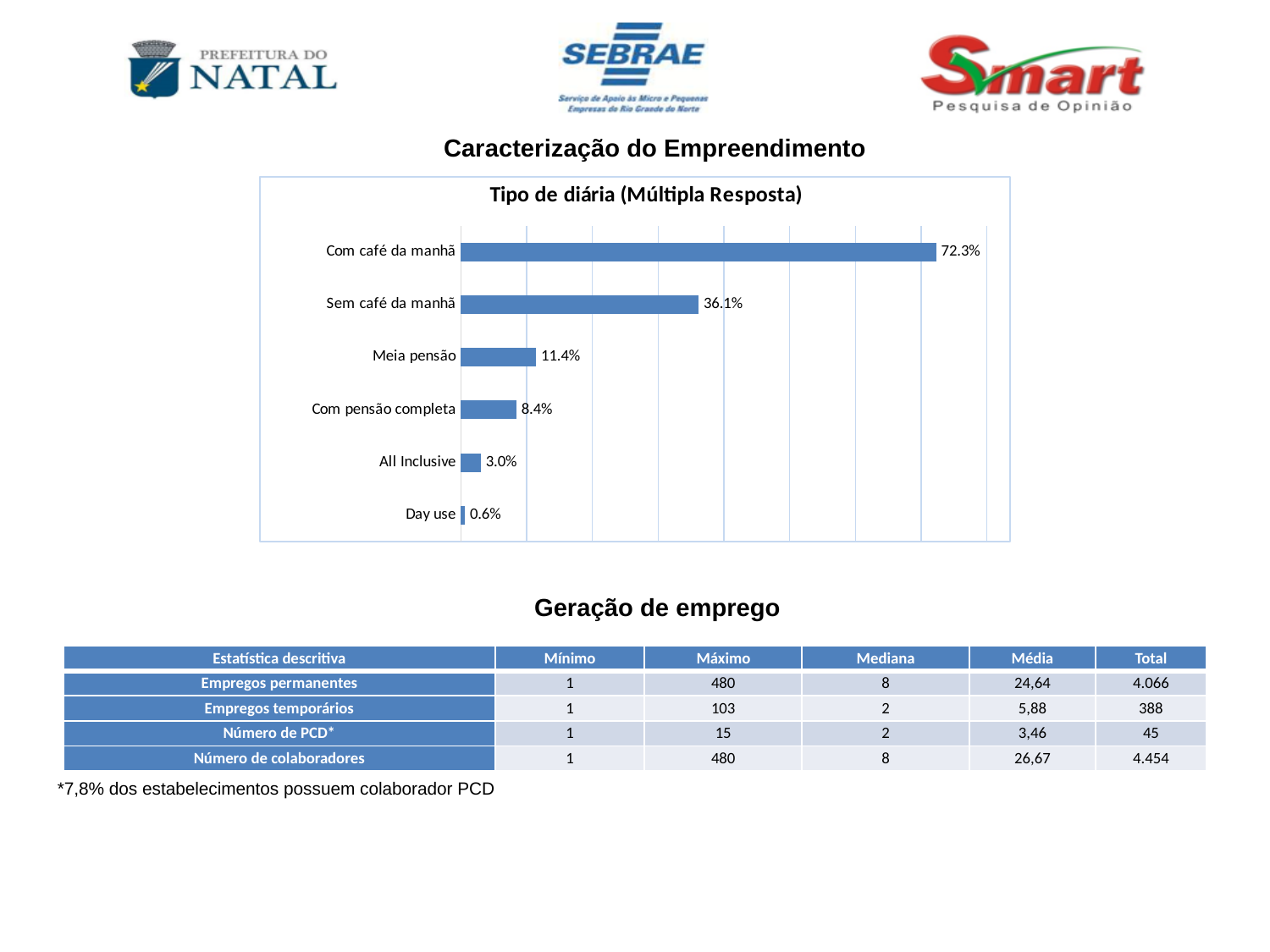
Which is larger in the "Tipo de diária (Múltipla Resposta)" chart: "Com pensão completa" or "All Inclusive"? Com pensão completa What is the difference between "Meia pensão" and "Com pensão completa" in the "Tipo de diária (Múltipla Resposta)" chart? 3.0% What is the value for "Sem café da manhã" in the "Tipo de diária (Múltipla Resposta)" chart? 36.1% Which category has the lowest value in the "Tipo de diária (Múltipla Resposta)" chart? Day use What type of chart is the "Tipo de diária (Múltipla Resposta)" chart? Bar chart Which category has the highest value in the "Tipo de diária (Múltipla Resposta)" chart? Com café da manhã How many categories are shown in the "Tipo de diária (Múltipla Resposta)" chart? 6 What is the value for "Meia pensão" in the "Tipo de diária (Múltipla Resposta)" chart? 11.4% What is the difference between "Com café da manhã" and "Sem café da manhã" in the "Tipo de diária (Múltipla Resposta)" chart? 36.2% What is the title of the chart on the slide? Tipo de diária (Múltipla Resposta) What is the value for "All Inclusive" in the "Tipo de diária (Múltipla Resposta)" chart? 3.0% What is the value for "Com café da manhã" in the "Tipo de diária (Múltipla Resposta)" chart? 72.3%